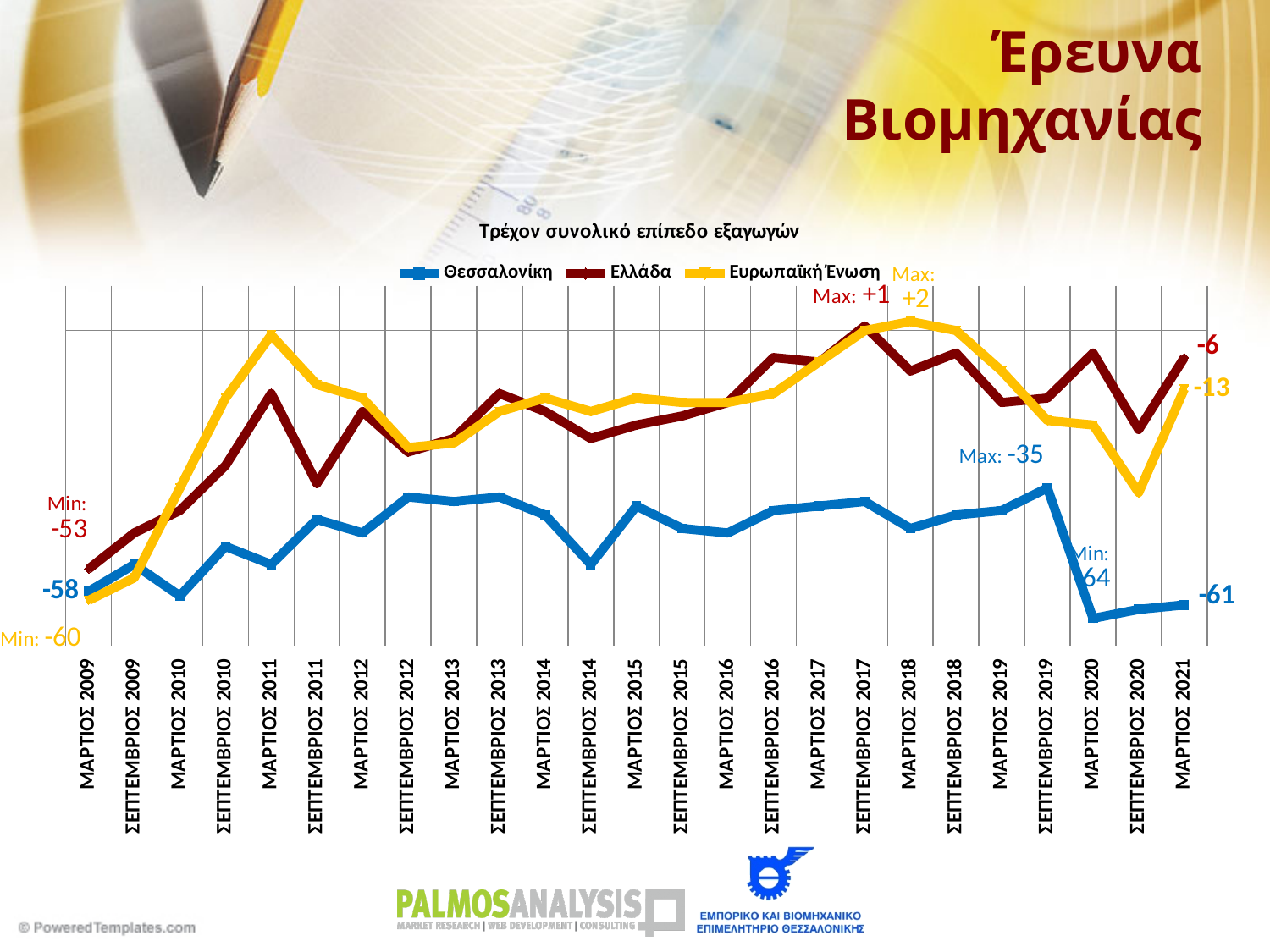
What is the value for Θεσσαλονίκη at ΜΑΡΤΙΟΣ 2009? -58 What is the maximum value reached by the Ελλάδα series, as labelled on the chart? +1 What is the value for Θεσσαλονίκη at ΜΑΡΤΙΟΣ 2021? -61 What is the value for Ελλάδα at ΜΑΡΤΙΟΣ 2021? -6 How many time points are shown on the x axis? 25 What type of chart is shown on the slide? line chart At ΜΑΡΤΙΟΣ 2021, which series has the higher value, Ελλάδα or Θεσσαλονίκη? Ελλάδα What is the minimum value reached by the Θεσσαλονίκη series, as labelled on the chart? -64 How many series does the legend list? 3 What is the title of the chart? Τρέχον συνολικό επίπεδο εξαγωγών What is the difference between the Ελλάδα and Ευρωπαϊκή Ένωση values at ΜΑΡΤΙΟΣ 2021? 7 What is the value for Ευρωπαϊκή Ένωση at ΜΑΡΤΙΟΣ 2021? -13